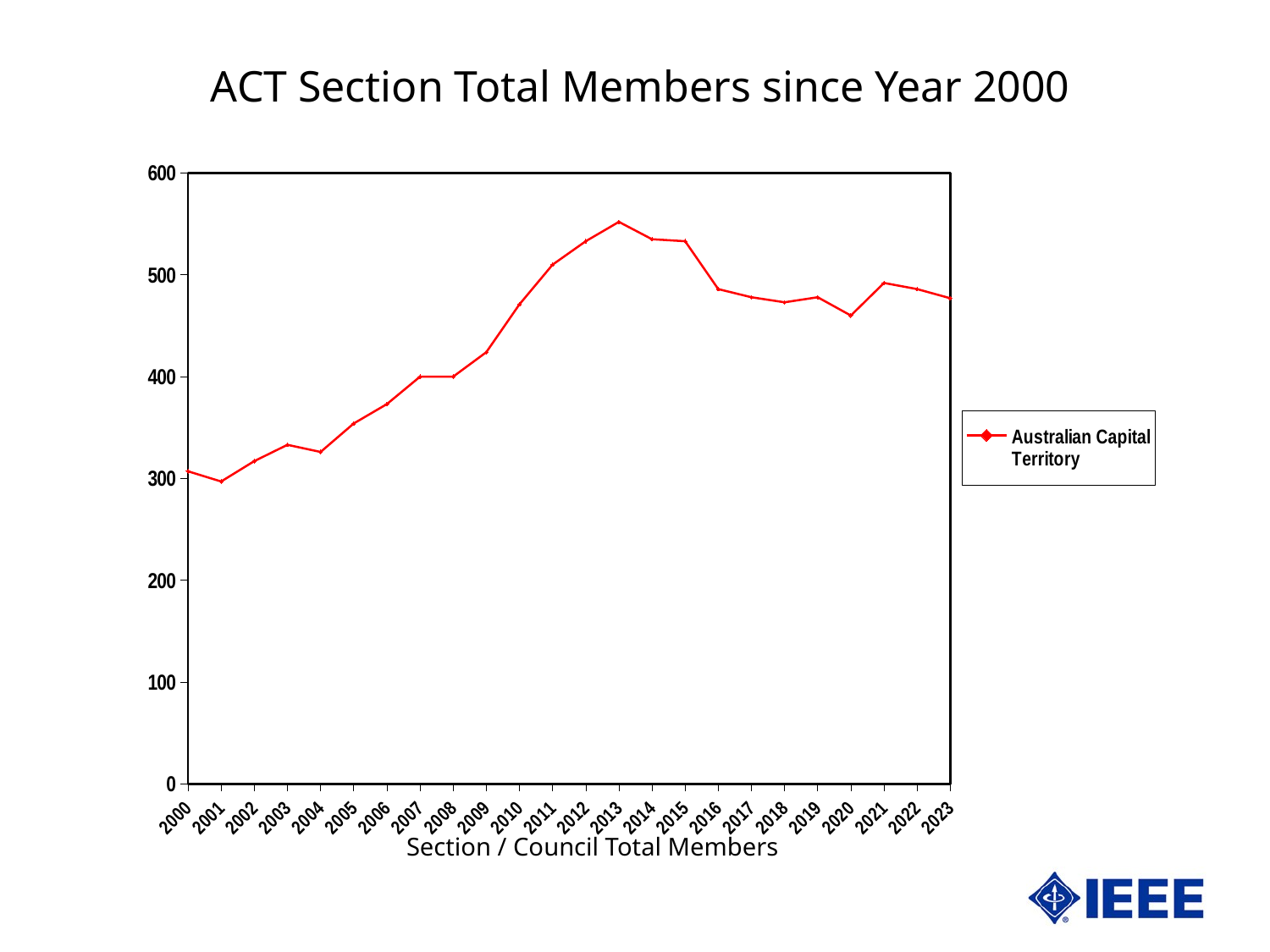
How many years are plotted along the x axis? 24 Do the values generally rise or fall from 2000 to 2013? rise How many series does the legend list? 1 What kind of chart is shown on the slide? line chart What is the title of the chart? ACT Section Total Members since Year 2000 Is the value for 2013 greater or less than 500? greater In which year is the number of members lowest? 2001 Which year has more members, 2010 or 2005? 2010 Is the value for 2020 greater or less than 500? less In which year is the number of members highest? 2013 What is the name of the series shown in the legend? Australian Capital Territory